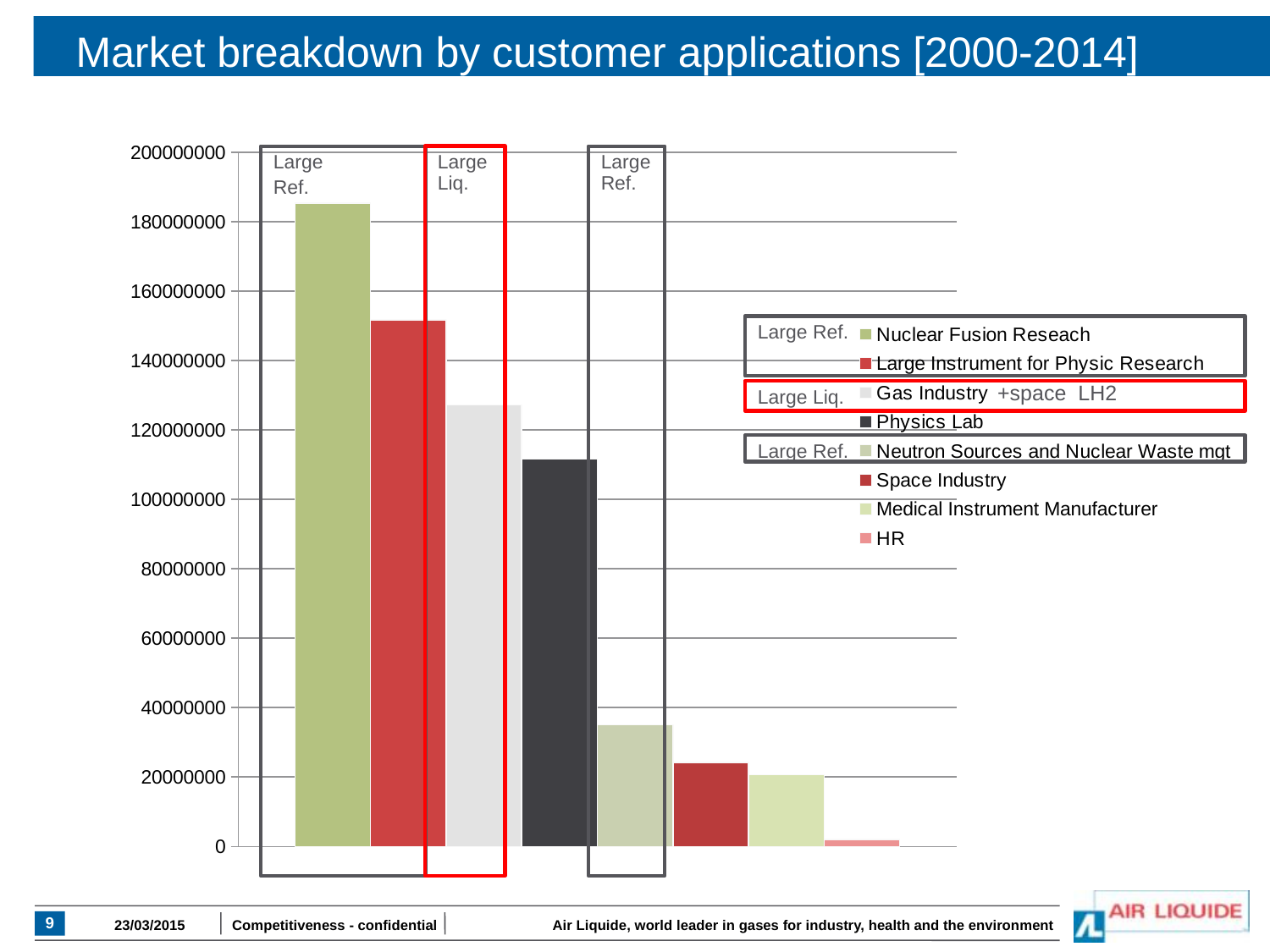
Is the value for Physics Lab greater or less than 100000000? greater How many series does the legend list? 8 Which series has the lowest value? HR Which is larger, the value for Physics Lab or the value for Space Industry? Physics Lab Is the value for Neutron Sources and Nuclear Waste mgt greater or less than 40000000? less What is the title of the slide? Market breakdown by customer applications [2000-2014] Is the value for HR greater or less than 20000000? less Do the bar values rise or fall from left to right across the chart? fall Which series has the highest value? Nuclear Fusion Reseach What kind of chart is shown on the slide? bar chart